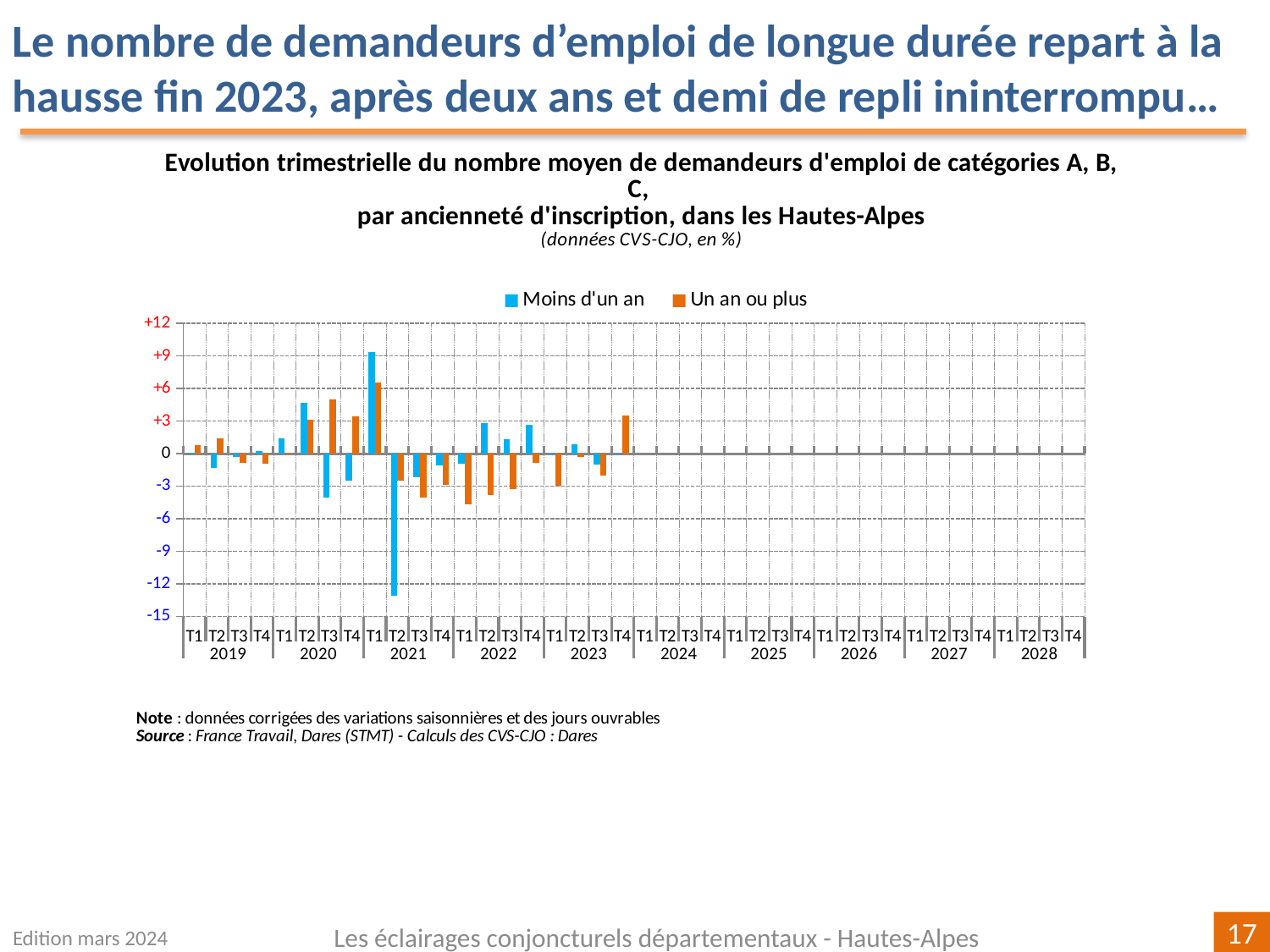
What are the two series named in the legend? Moins d'un an; Un an ou plus How many series does the legend list? 2 In which quarter does the 'Moins d'un an' series reach its highest value? T1 2021 Is the value for 'Un an ou plus' in T1 2022 greater or less than -3? less What kind of chart is shown on the slide? bar chart In which quarter does the 'Un an ou plus' series reach its highest value? T1 2021 Is the value for 'Moins d'un an' in T1 2021 greater or less than +6? greater In T1 2021, which series has the larger value, 'Moins d'un an' or 'Un an ou plus'? Moins d'un an How many years are labelled along the x axis? 10 Is the value for 'Moins d'un an' in T2 2021 greater or less than -12? less In which quarter does the 'Moins d'un an' series reach its lowest value? T2 2021 In T4 2023, which series has the larger value, 'Moins d'un an' or 'Un an ou plus'? Un an ou plus